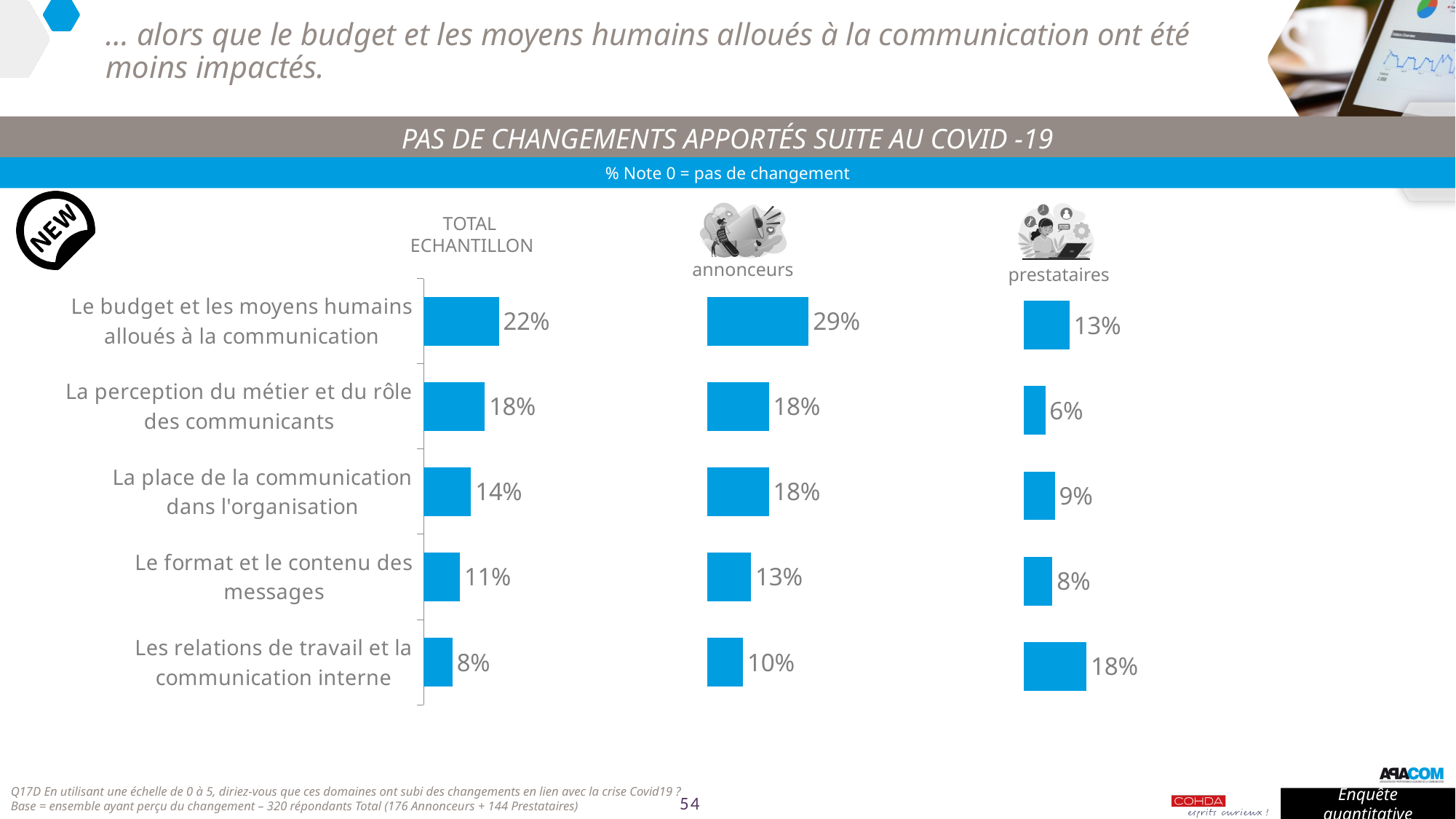
What kind of chart is used for the TOTAL ECHANTILLON data? bar chart In the TOTAL ECHANTILLON chart, do the values rise or fall from the top category to the bottom category? fall In the annonceurs chart, what is the difference between the value for "Le budget et les moyens humains alloués à la communication" and the value for "Les relations de travail et la communication interne"? 19% In the prestataires chart, which category has the highest value? Les relations de travail et la communication interne In the prestataires chart, what is the value for "La perception du métier et du rôle des communicants"? 6% In the TOTAL ECHANTILLON chart, what is the value for "Le budget et les moyens humains alloués à la communication"? 22% In the annonceurs chart, which category has the highest value? Le budget et les moyens humains alloués à la communication In the TOTAL ECHANTILLON chart, which category has the lowest value? Les relations de travail et la communication interne What is the difference between the TOTAL ECHANTILLON value and the prestataires value for "La place de la communication dans l'organisation"? 5% How many categories are shown in the TOTAL ECHANTILLON chart? 5 For "Le format et le contenu des messages", which is larger: the annonceurs value or the prestataires value? annonceurs In the annonceurs chart, what is the value for "Le budget et les moyens humains alloués à la communication"? 29%